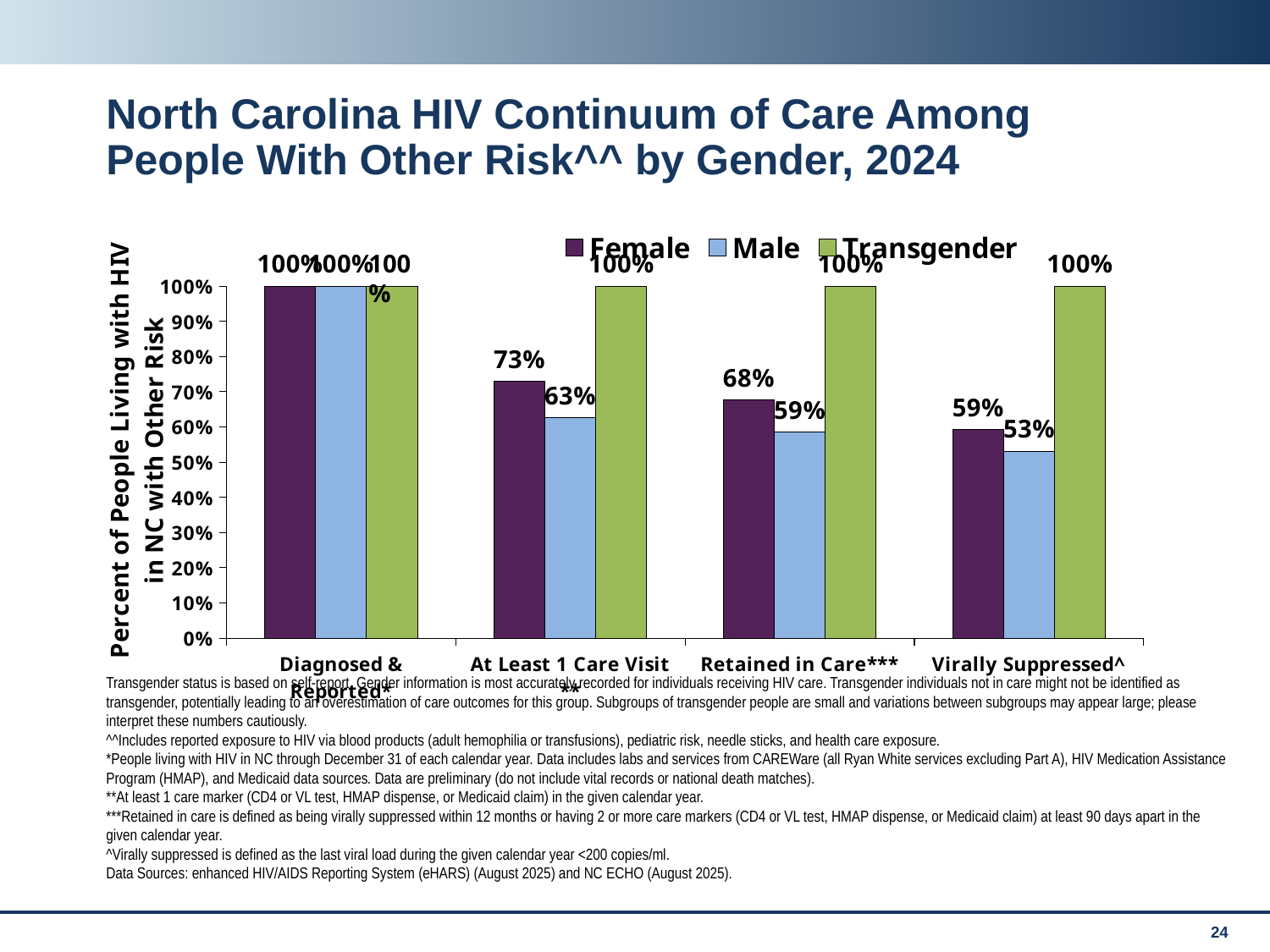
What is the difference between the Female values for Retained in Care*** and Virally Suppressed^? 9% What is the Transgender value for Virally Suppressed^? 100% How many series does the legend list? 3 What is the difference between the Female and Male values for At Least 1 Care Visit**? 10% How many categories are shown on the x axis? 4 What is the Male value for Virally Suppressed^? 53% What kind of chart is shown on the slide? Bar chart What is the Male value for Retained in Care***? 59% What is the Female value for At Least 1 Care Visit**? 73% Which is larger for Retained in Care***, the Female value or the Male value? Female Do the Male values rise or fall from Diagnosed & Reported* to Virally Suppressed^? Fall Which category has the lowest Female value? Virally Suppressed^